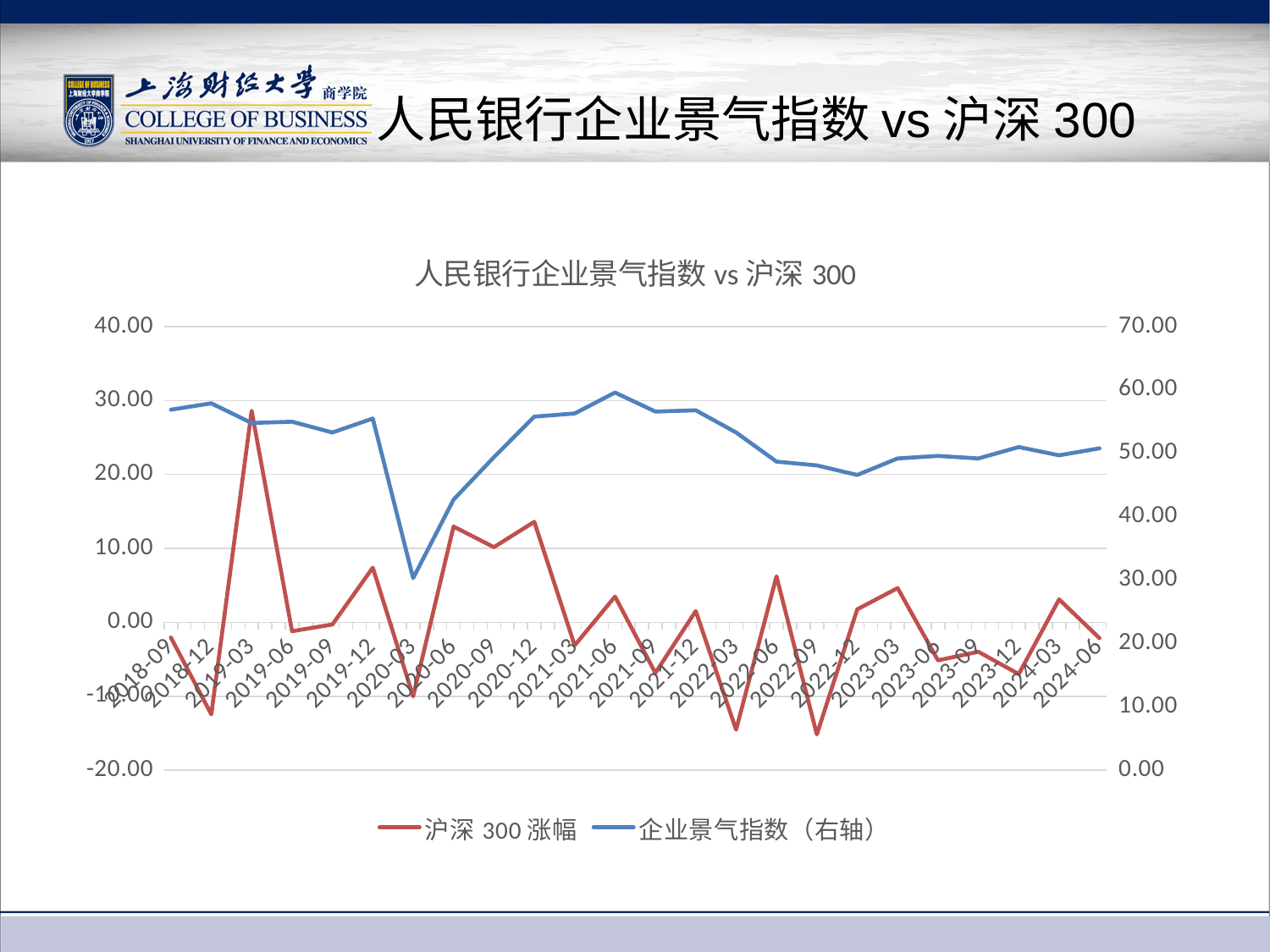
At which date does the 沪深 300 涨幅 series reach its highest value? 2019-03 Is the value of 沪深 300 涨幅 at 2019-03 greater or less than 20.00? greater Is the value of 沪深 300 涨幅 at 2022-09 greater or less than -10.00? less What kind of chart is shown on the slide? line chart At which date does the 企业景气指数（右轴） series reach its lowest value? 2020-03 Does the 企业景气指数（右轴） series rise or fall between 2020-03 and 2021-06? rise At which date does the 企业景气指数（右轴） series reach its highest value? 2021-06 Which series is drawn in blue? 企业景气指数（右轴） How many series does the legend list? 2 Is the value of 企业景气指数（右轴） at 2020-03 greater or less than 40.00 on the right axis? less How many time points are plotted along the x axis? 24 Which is larger: the 沪深 300 涨幅 value at 2019-03 or at 2020-12? 2019-03